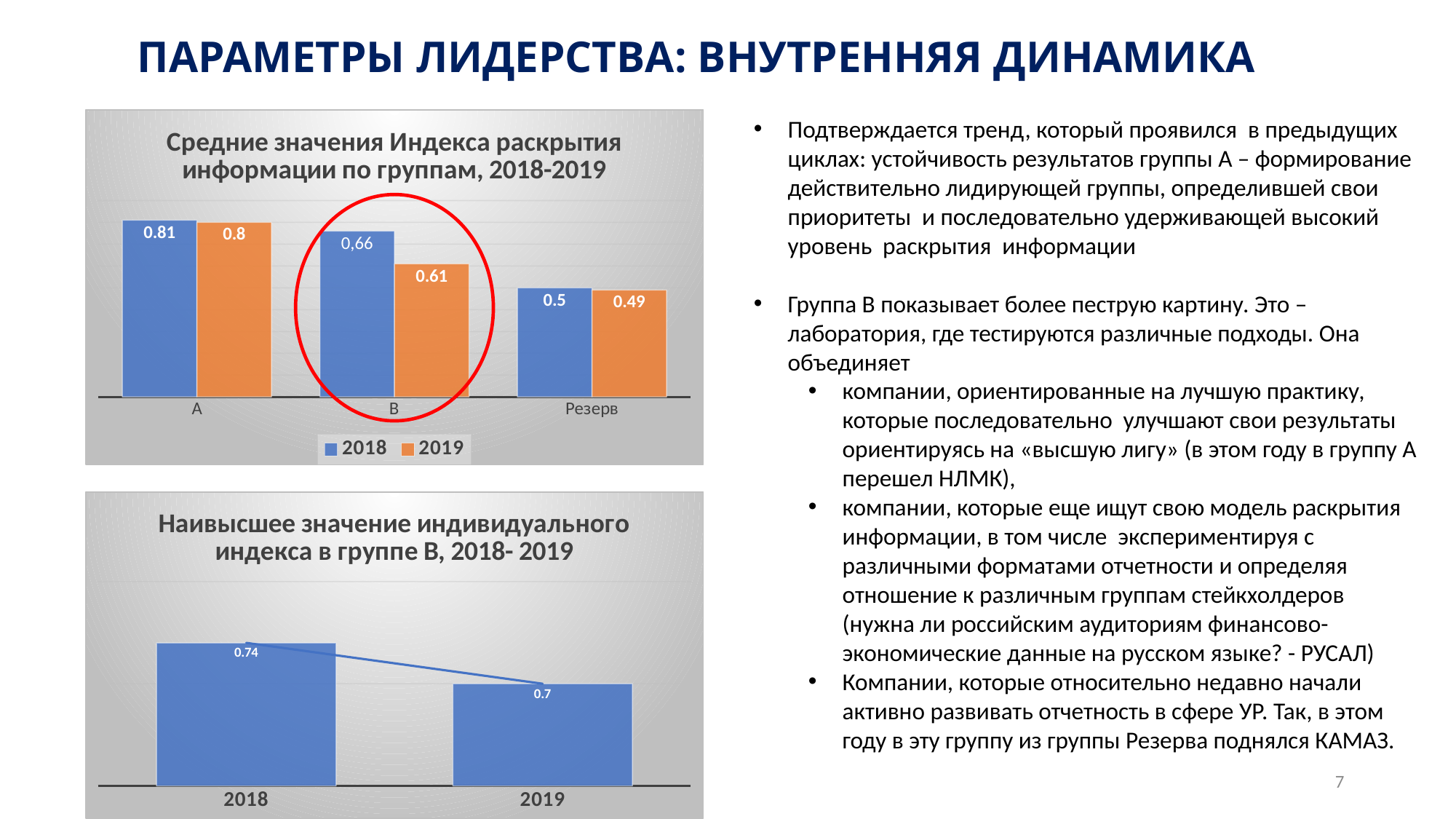
In the bottom chart, do the values rise or fall from 2018 to 2019? fall In the top chart, what is the difference between the 2018 and 2019 values for group A? 0.01 In the top chart, how many groups are shown on the x axis? 3 In the top chart, which group has the lowest 2018 value? Резерв In the top chart, how many series does the legend list? 2 In the top chart, what is the 2018 value for group B as printed on the slide? 0,66 In the top chart, what is the 2019 value for group B? 0.61 In the top chart, which group has the highest 2019 value? A In the bottom chart (Наивысшее значение индивидуального индекса в группе B, 2018- 2019), what is the value for 2019? 0.7 In the top chart (Средние значения Индекса раскрытия информации по группам, 2018-2019), what is the 2018 value for group A? 0.81 In the top chart, what is the 2019 value for Резерв? 0.49 In the bottom chart, what is the difference between the 2018 and 2019 values? 0.04